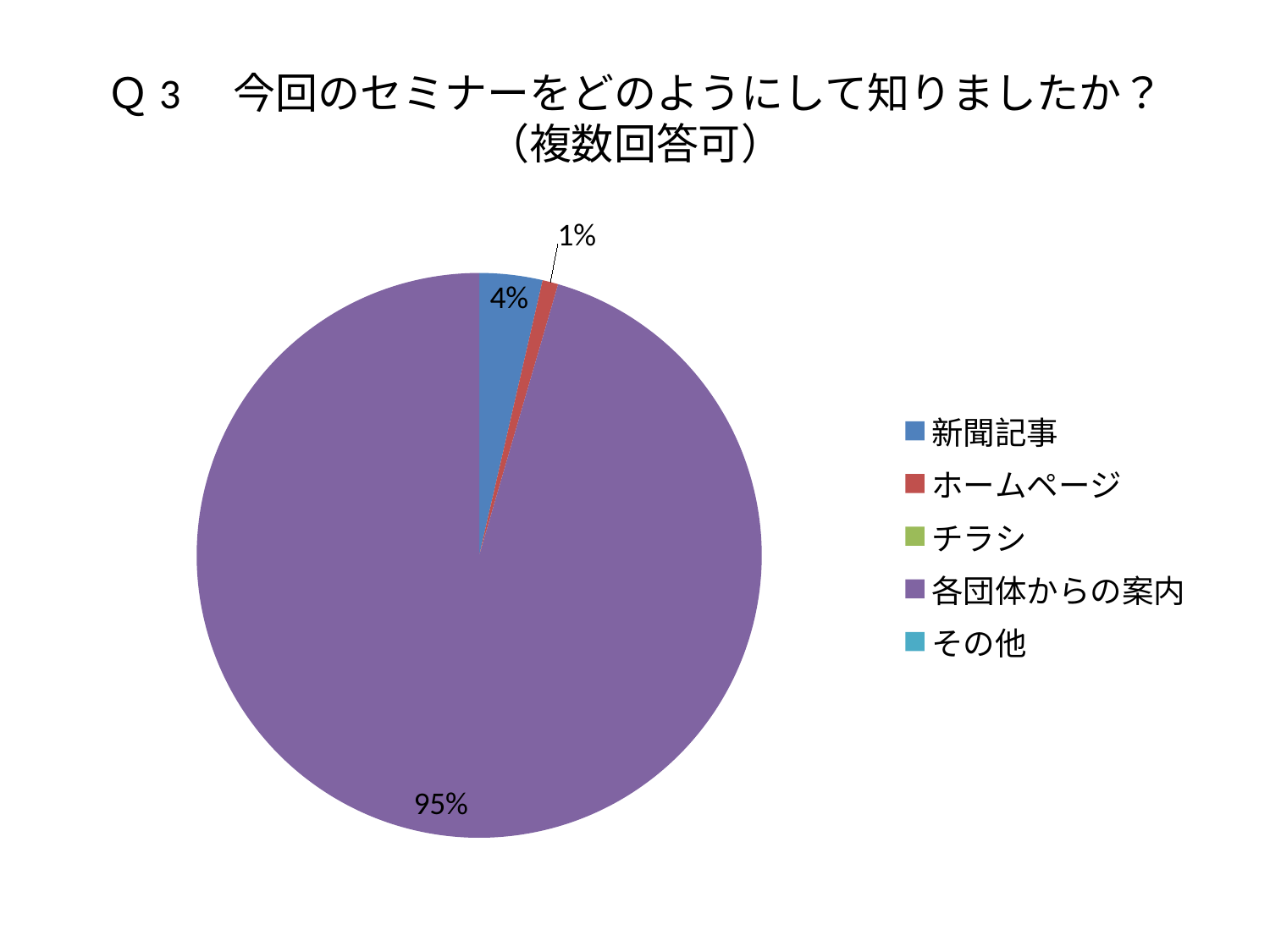
What colour is the slice for 各団体からの案内? Purple How many percentage points larger is 各団体からの案内 than 新聞記事? 91 percentage points Which is larger, the slice for 新聞記事 or the slice for ホームページ? 新聞記事 How many percentage points larger is 新聞記事 than ホームページ? 3 percentage points What is the title of the chart? Q３ 今回のセミナーをどのようにして知りましたか？（複数回答可） What kind of chart is shown on the slide? Pie chart Which category has the largest slice of the pie? 各団体からの案内 What percentage is shown for 新聞記事? 4% What percentage is shown for ホームページ? 1% How many categories does the legend list? 5 What share of the pie does 各団体からの案内 account for? 95%